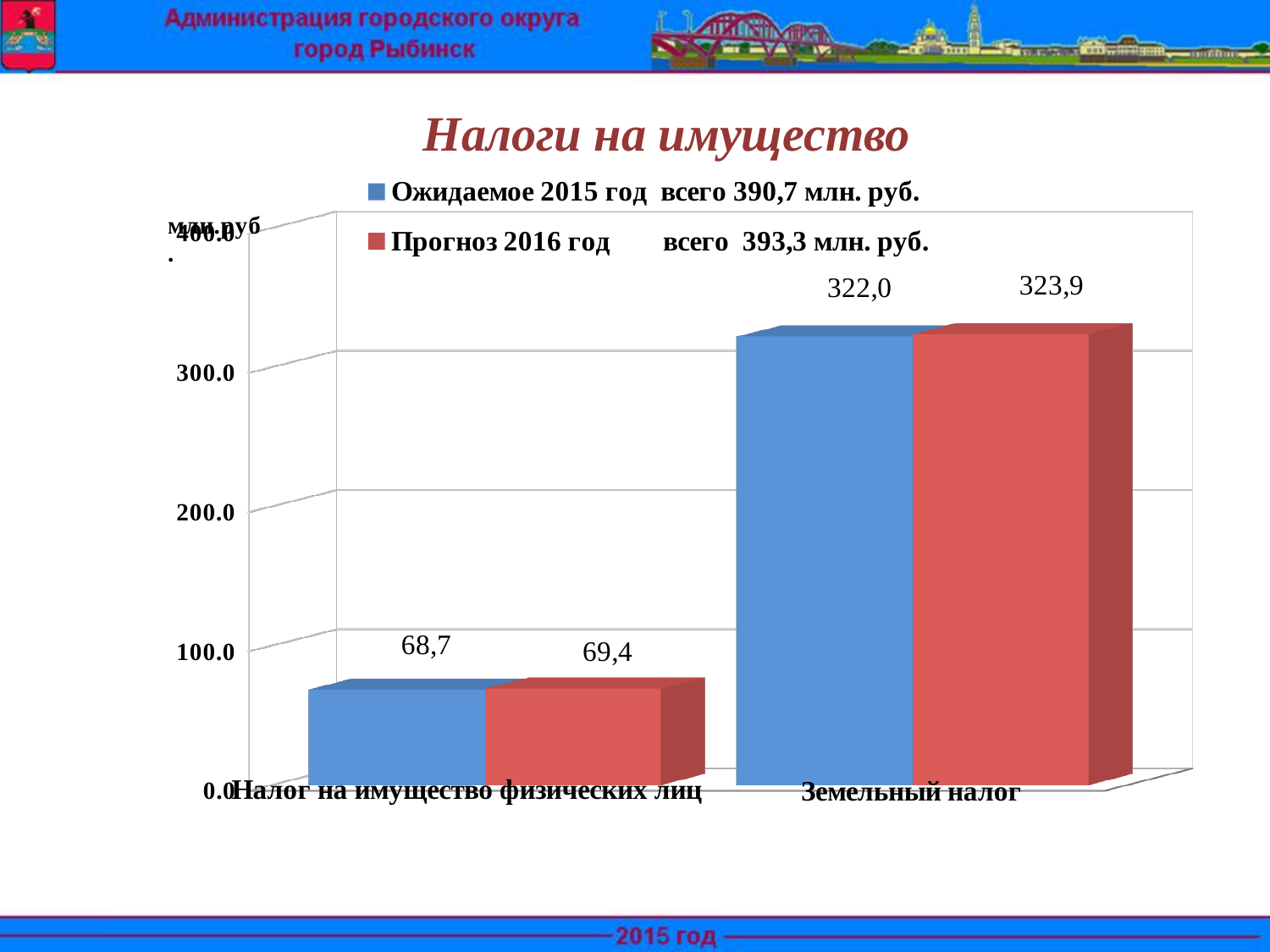
How many categories are shown on the x axis? 2 Is the value for Земельный налог in the Ожидаемое 2015 год series greater or less than 300.0? greater What is the value for Налог на имущество физических лиц in the Прогноз 2016 год series? 69,4 Which category has the lowest value in the Ожидаемое 2015 год series? Налог на имущество физических лиц What is the difference between the Прогноз 2016 год and Ожидаемое 2015 год values for Земельный налог? 1,9 What is the value for Земельный налог in the Ожидаемое 2015 год series? 322,0 How many series does the legend list? 2 Which is larger for Налог на имущество физических лиц: the Ожидаемое 2015 год value or the Прогноз 2016 год value? Прогноз 2016 год What kind of chart is shown on the slide? bar chart What is the value for Налог на имущество физических лиц in the Ожидаемое 2015 год series? 68,7 Which category has the highest value in the Прогноз 2016 год series? Земельный налог What is the value for Земельный налог in the Прогноз 2016 год series? 323,9